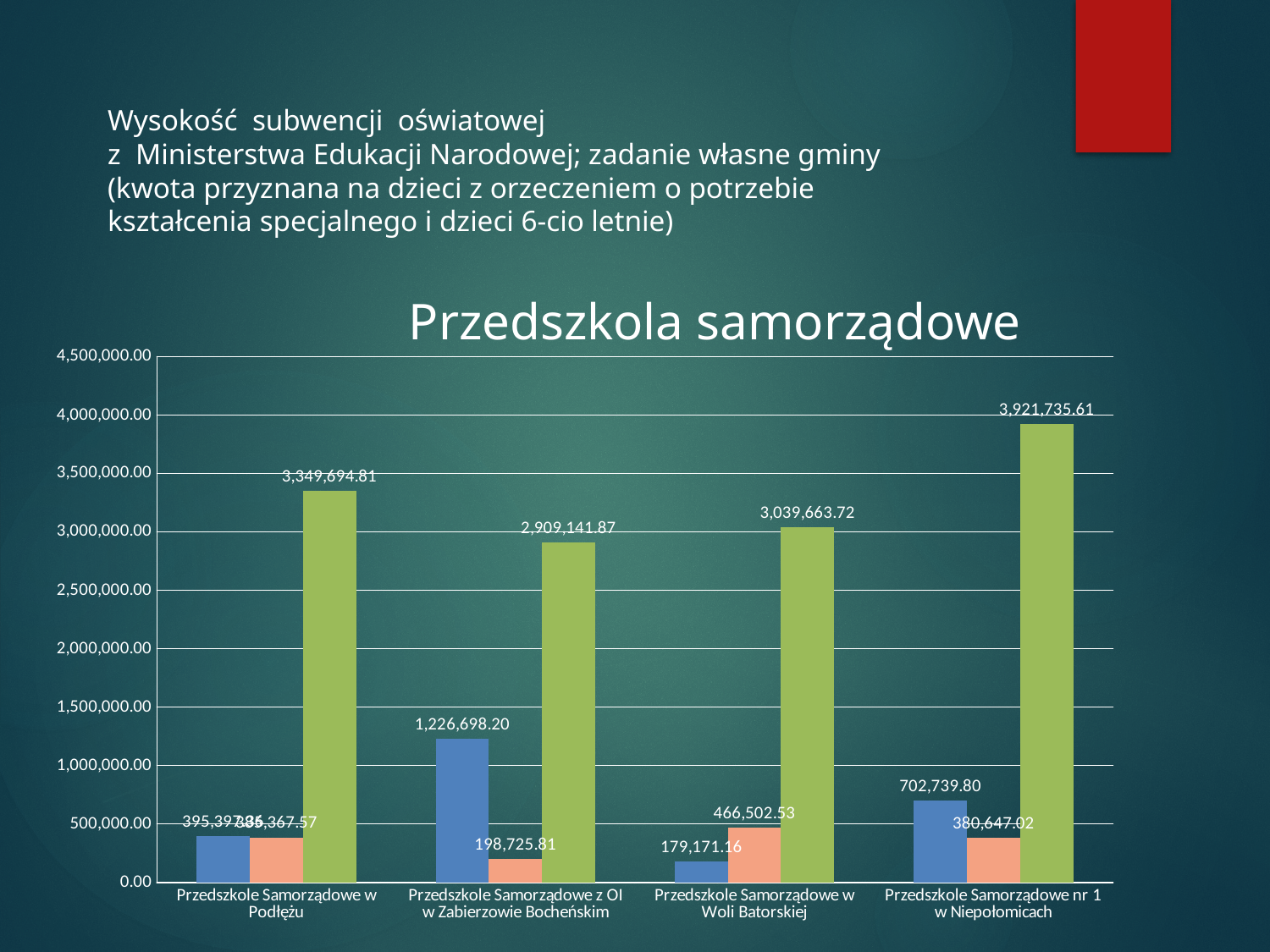
Which kindergarten has the highest blue bar? Przedszkole Samorządowe z OI w Zabierzowie Bocheńskim What is the value of the orange bar for Przedszkole Samorządowe w Woli Batorskiej? 466,502.53 How many kindergartens (categories) are shown on the x axis of the chart? 4 What is the value of the green bar for Przedszkole Samorządowe z OI w Zabierzowie Bocheńskim? 2,909,141.87 What type of chart is shown on the slide? bar chart What is the value of the blue bar for Przedszkole Samorządowe z OI w Zabierzowie Bocheńskim? 1,226,698.20 What is the value of the green bar for Przedszkole Samorządowe nr 1 w Niepołomicach? 3,921,735.61 Which kindergarten has the highest green bar? Przedszkole Samorządowe nr 1 w Niepołomicach What is the title of the chart? Przedszkola samorządowe What is the difference between the green bar for Przedszkole Samorządowe nr 1 w Niepołomicach and the green bar for Przedszkole Samorządowe w Podłężu? 572,040.80 For Przedszkole Samorządowe w Woli Batorskiej, which is larger: the blue bar or the orange bar? the orange bar Which kindergarten has the lowest green bar? Przedszkole Samorządowe z OI w Zabierzowie Bocheńskim